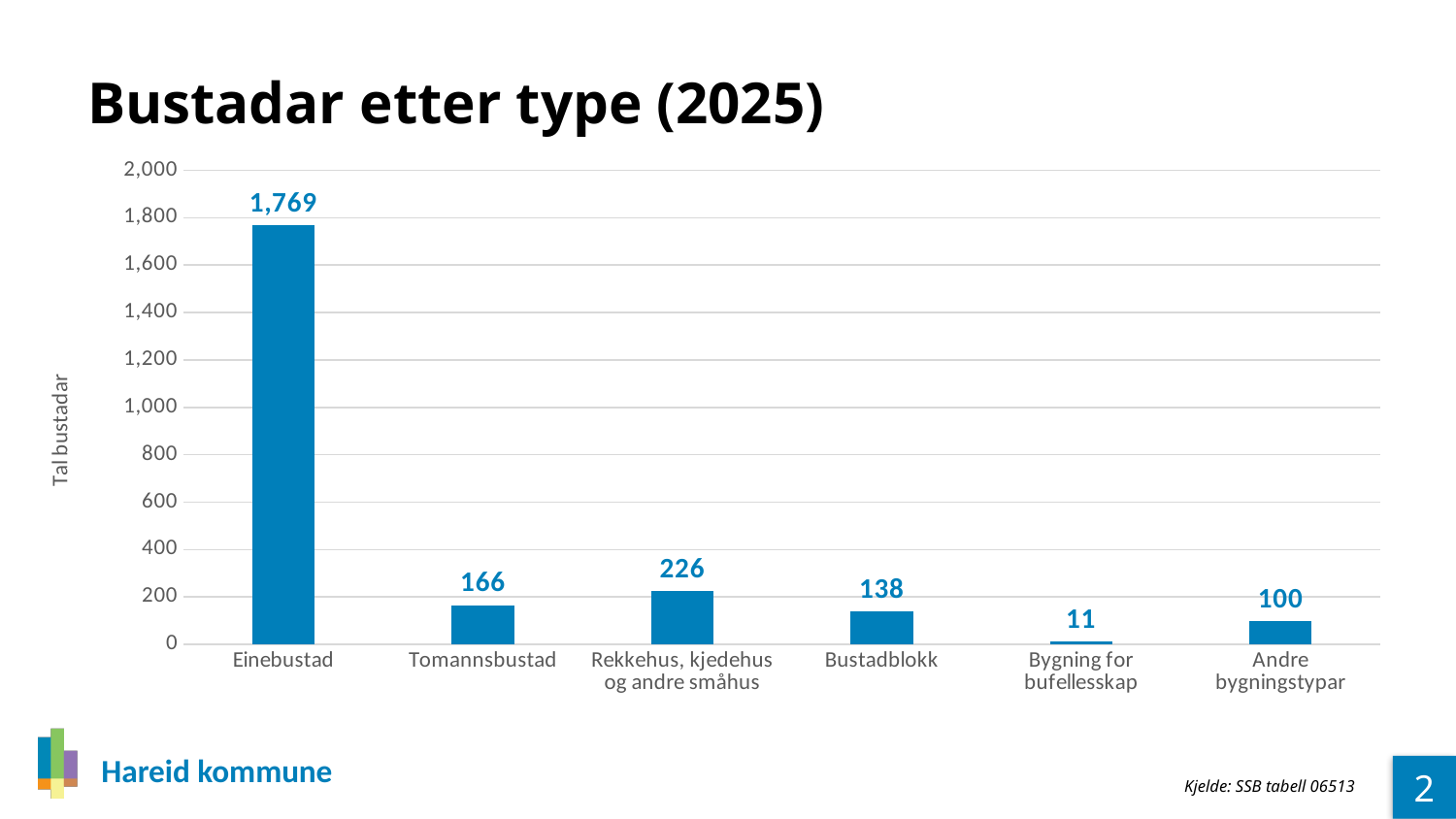
What kind of chart is shown on the slide? bar chart What is the value for Andre bygningstypar? 100 Which category has the highest value? Einebustad How many categories are shown on the x axis? 6 Which is larger, the value for Tomannsbustad or the value for Bustadblokk? Tomannsbustad What is the difference between the values for Rekkehus, kjedehus og andre småhus and Tomannsbustad? 60 What is the value for Bygning for bufellesskap? 11 What is the value for Einebustad? 1,769 Which category has the lowest value? Bygning for bufellesskap What is the value for Rekkehus, kjedehus og andre småhus? 226 Is the value for Einebustad greater or less than 1,600? greater What is the title of the chart? Bustadar etter type (2025)